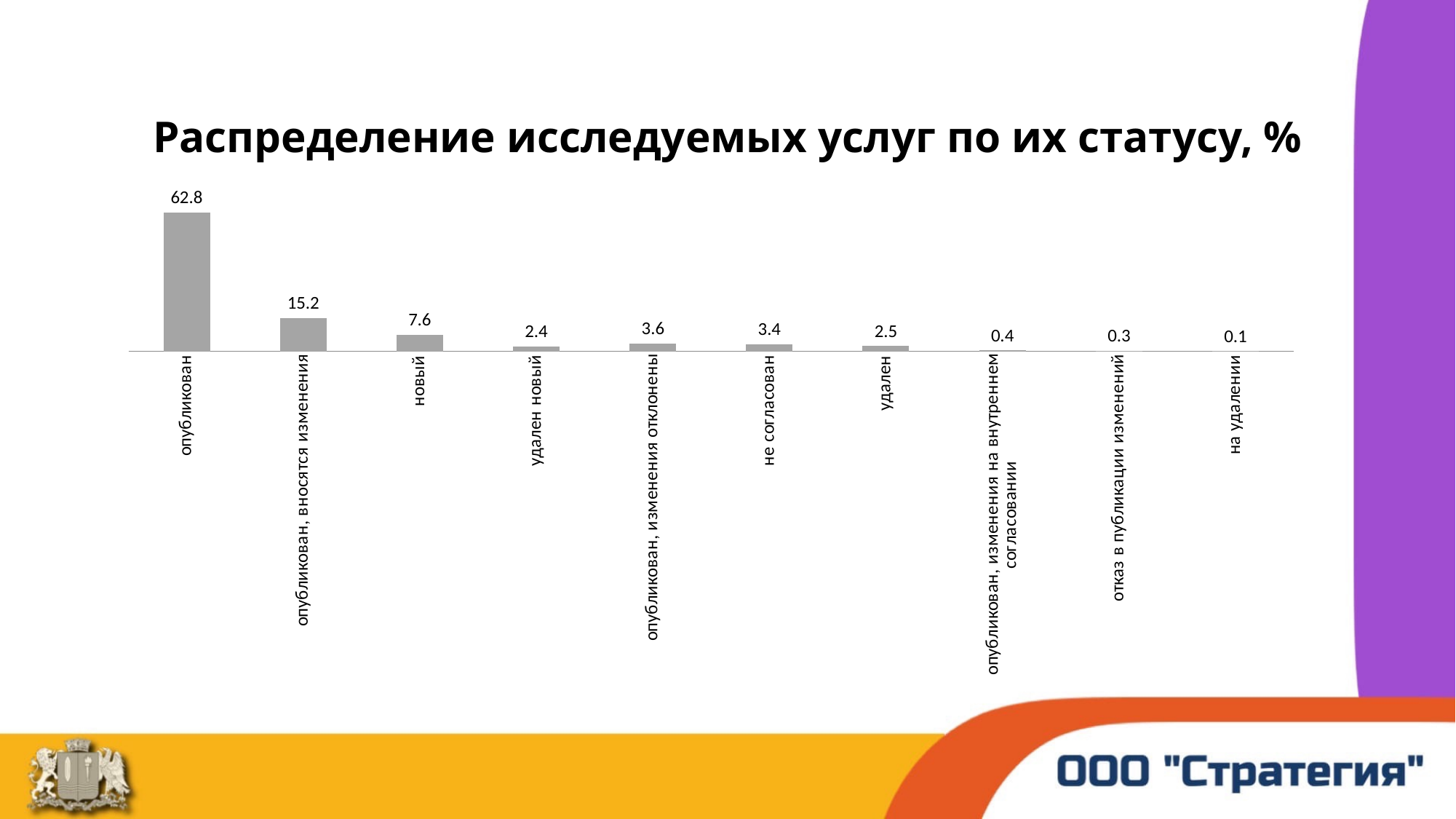
What is the difference between the values for "опубликован" and "опубликован, вносятся изменения"? 47.6 What is the value for "не согласован"? 3.4 Which category has the highest value? опубликован What kind of chart is shown on the slide? bar chart How many categories are shown in the chart? 10 What is the difference between the values for "новый" and "удален новый"? 5.2 What is the value for "опубликован, вносятся изменения"? 15.2 Which category has the lowest value? на удалении What is the value for "отказ в публикации изменений"? 0.3 Which is larger: the value for "опубликован, изменения отклонены" or the value for "удален"? опубликован, изменения отклонены What is the title of the chart? Распределение исследуемых услуг по их статусу, % What is the value for "опубликован"? 62.8